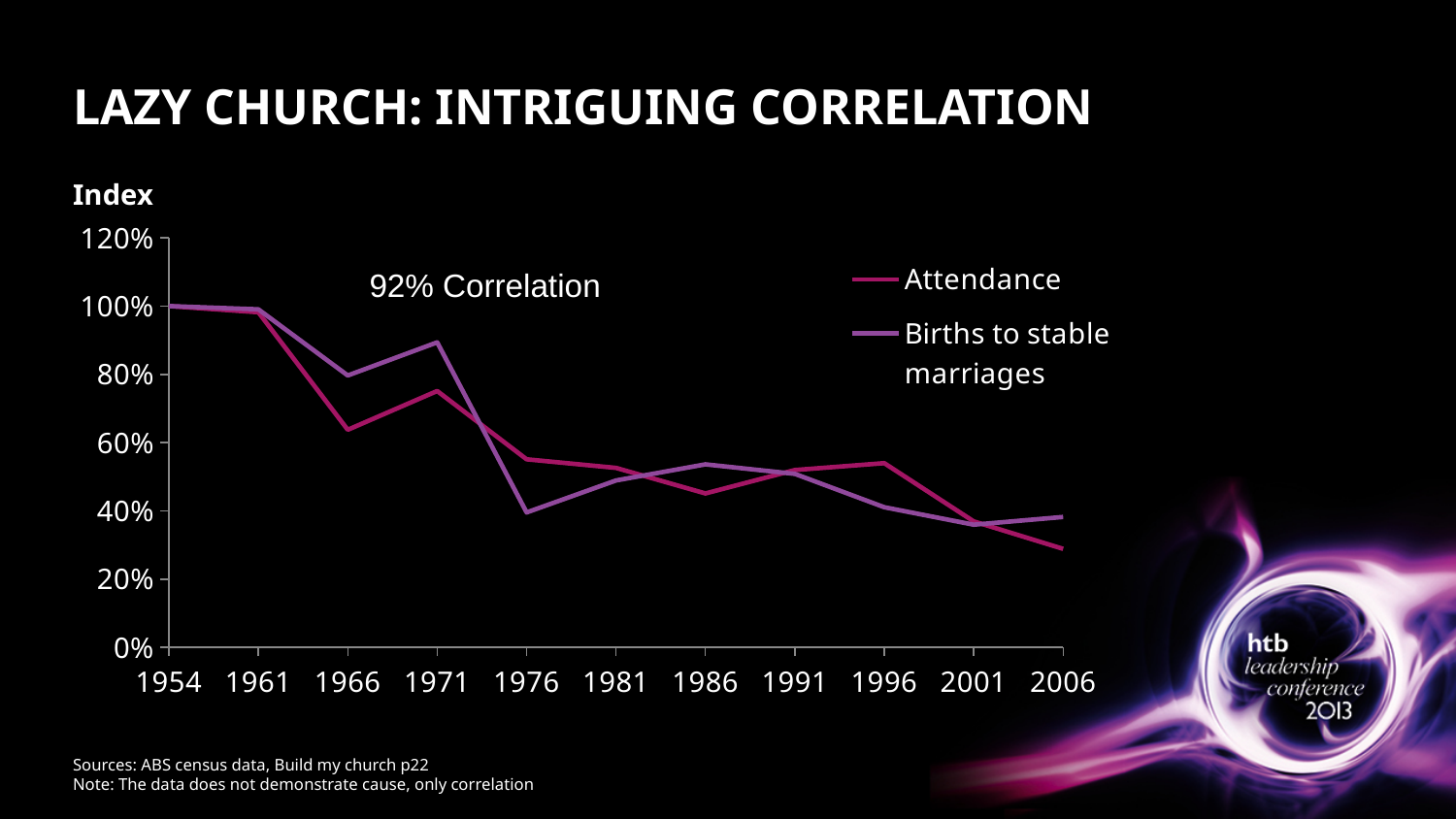
Is the Attendance value in 2006 greater or less than 40%? less How many years are shown along the x axis? 11 How many series does the legend list? 2 What is the Attendance value in 1954? 100% In 1971, which series has the higher value, Attendance or Births to stable marriages? Births to stable marriages What kind of chart is shown on the slide? line chart Is the Attendance value in 1976 greater or less than 60%? less In 1976, which series has the higher value, Attendance or Births to stable marriages? Attendance What correlation figure is printed on the chart? 92% Correlation Does the Attendance series generally rise or fall from 1954 to 2006? fall Is the Births to stable marriages value in 1971 greater or less than 80%? greater